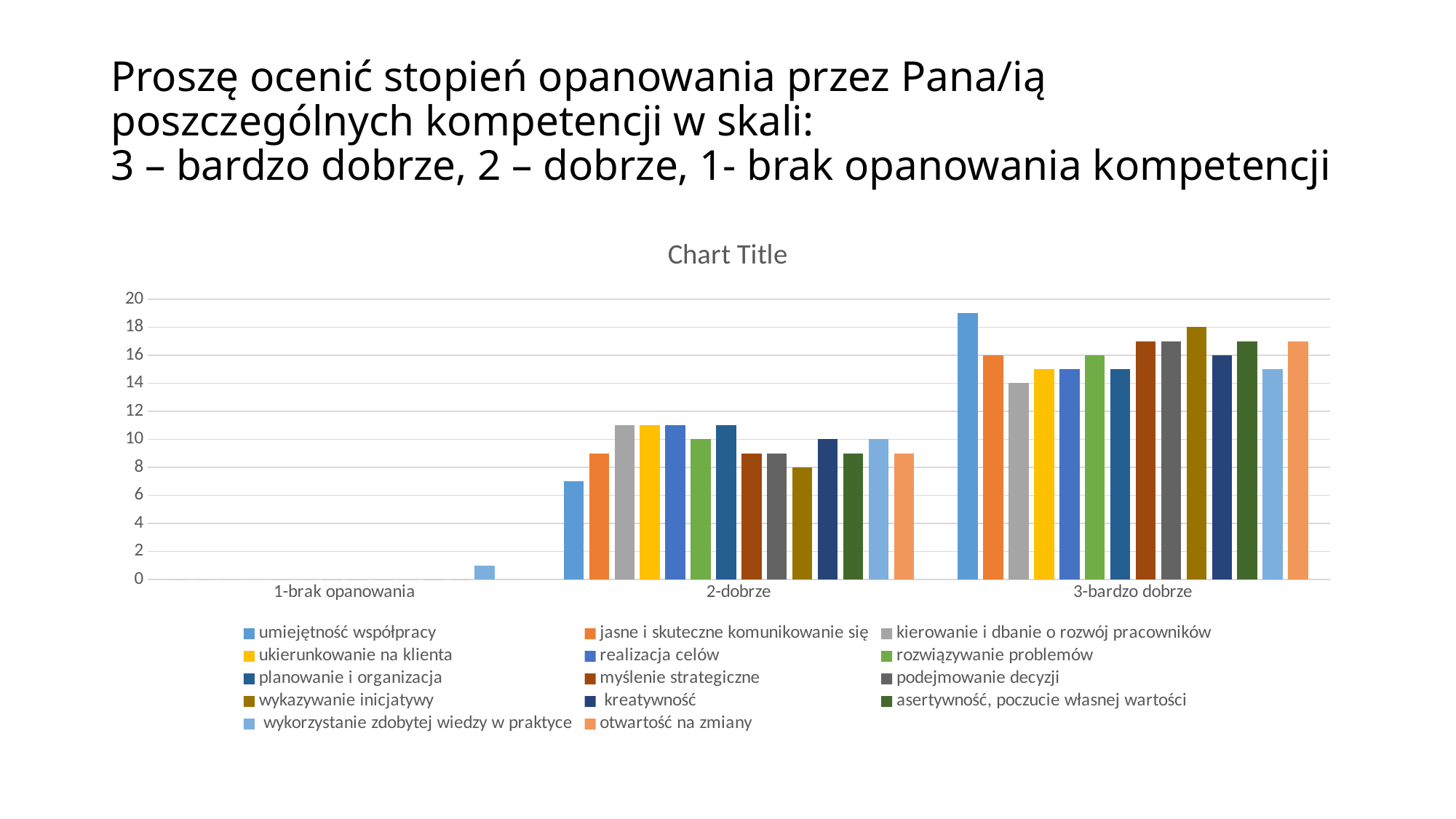
In the 2-dobrze category, which is larger: kierowanie i dbanie o rozwój pracowników or myślenie strategiczne? kierowanie i dbanie o rozwój pracowników What kind of chart is shown on the slide? bar chart Is the value for umiejętność współpracy in the 2-dobrze category greater or less than 8? less Which series has the lowest value in the 2-dobrze category? umiejętność współpracy How many categories are shown on the x axis? 3 What is the title of the chart? Chart Title What is the value for jasne i skuteczne komunikowanie się in the 3-bardzo dobrze category? 16 Is the value for umiejętność współpracy in the 3-bardzo dobrze category greater or less than 18? greater Which series is the only one with a visible bar in the 1-brak opanowania category? wykorzystanie zdobytej wiedzy w praktyce What is the value for wykazywanie inicjatywy in the 3-bardzo dobrze category? 18 How many series does the legend list? 14 Which series has the highest value in the 3-bardzo dobrze category? umiejętność współpracy